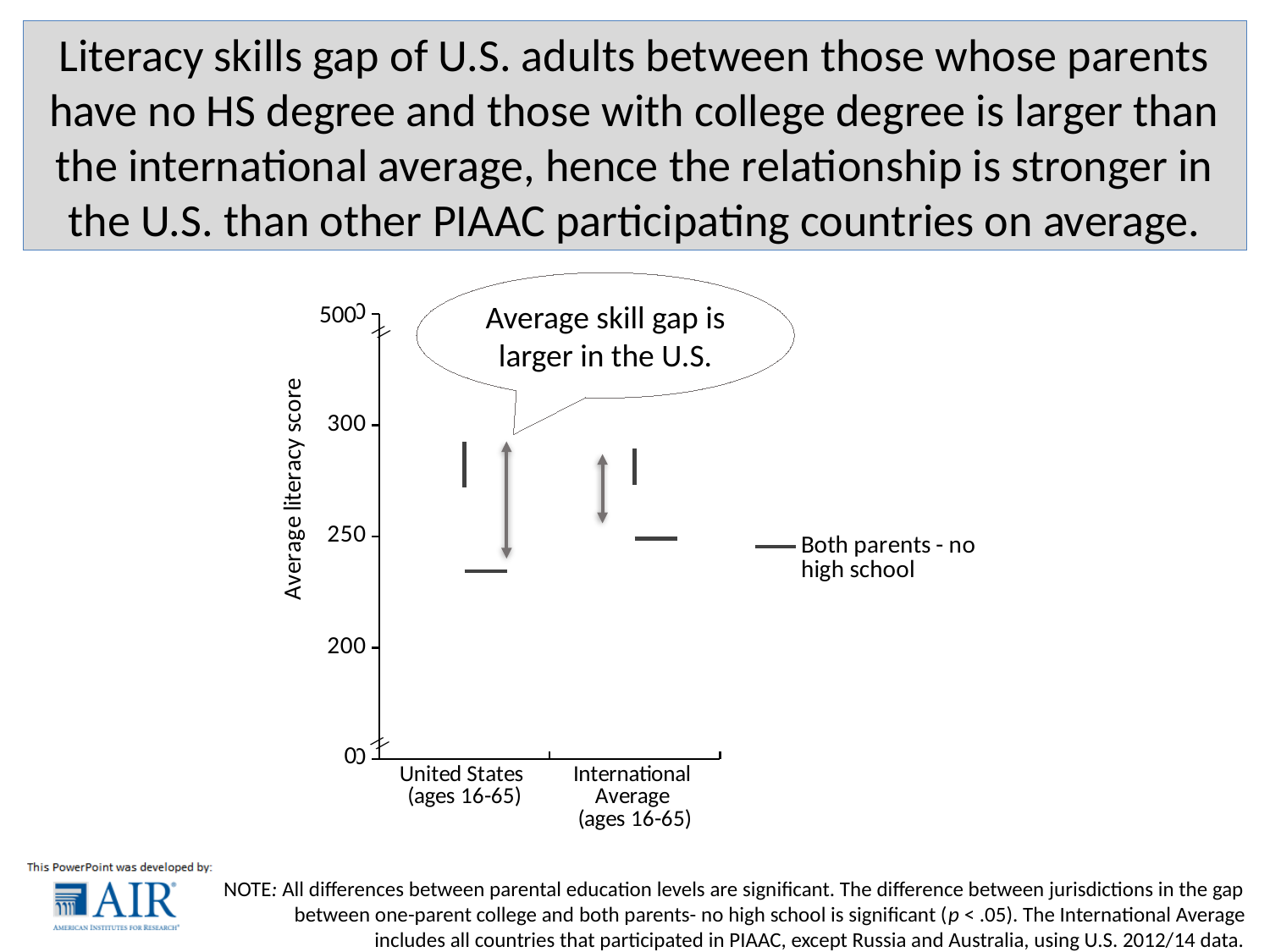
How many categories are shown on the x axis of the chart? 2 What is the label of the series listed in the chart's legend? Both parents - no high school What is the highest tick value shown on the chart's y axis? 500 Is the 'Both parents - no high school' value for International Average (ages 16-65) greater or less than 300? less How many series does the chart's legend list? 1 Is the 'Both parents - no high school' value for International Average (ages 16-65) greater or less than 200? greater Which category has the lowest 'Both parents - no high school' value? United States (ages 16-65) Is the 'Both parents - no high school' value for United States (ages 16-65) greater or less than 200? greater What is the label of the chart's y axis? Average literacy score Which category has the higher 'Both parents - no high school' value, United States (ages 16-65) or International Average (ages 16-65)? International Average (ages 16-65)